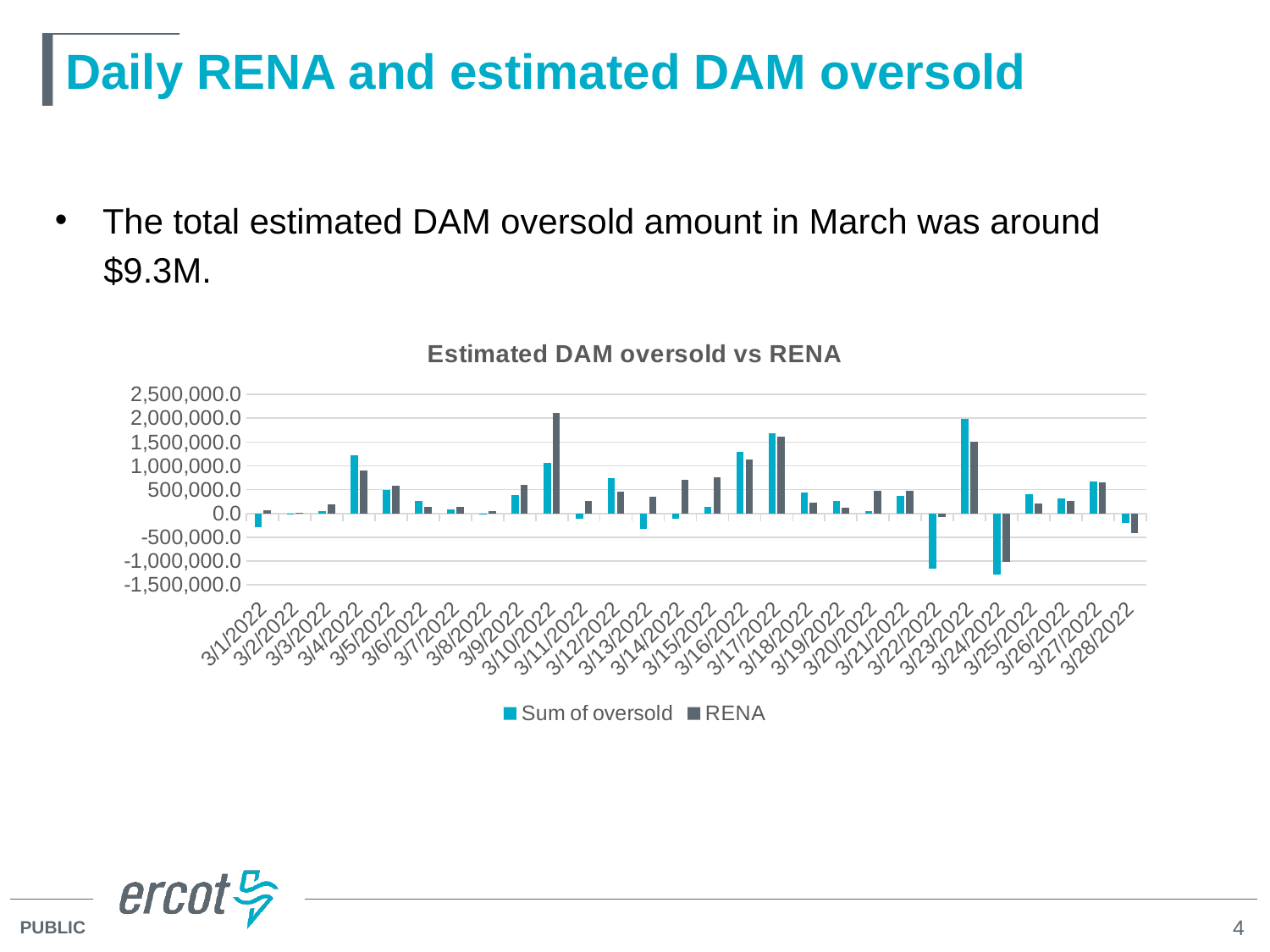
What is the title of the chart? Estimated DAM oversold vs RENA Is the Sum of oversold value for 3/24/2022 greater or less than -1,000,000.0? less Is the RENA value for 3/10/2022 greater or less than 1,500,000.0? greater Is the Sum of oversold value for 3/4/2022 greater or less than 1,000,000.0? greater On which date is the Sum of oversold value highest? 3/23/2022 On which date is the RENA value lowest? 3/24/2022 On which date is the RENA value highest? 3/10/2022 How many dates are shown along the x axis of the chart? 28 On 3/10/2022, which is larger: Sum of oversold or RENA? RENA How many series does the chart's legend list? 2 What kind of chart is shown on the slide? Bar chart Which series is drawn in teal in the chart? Sum of oversold